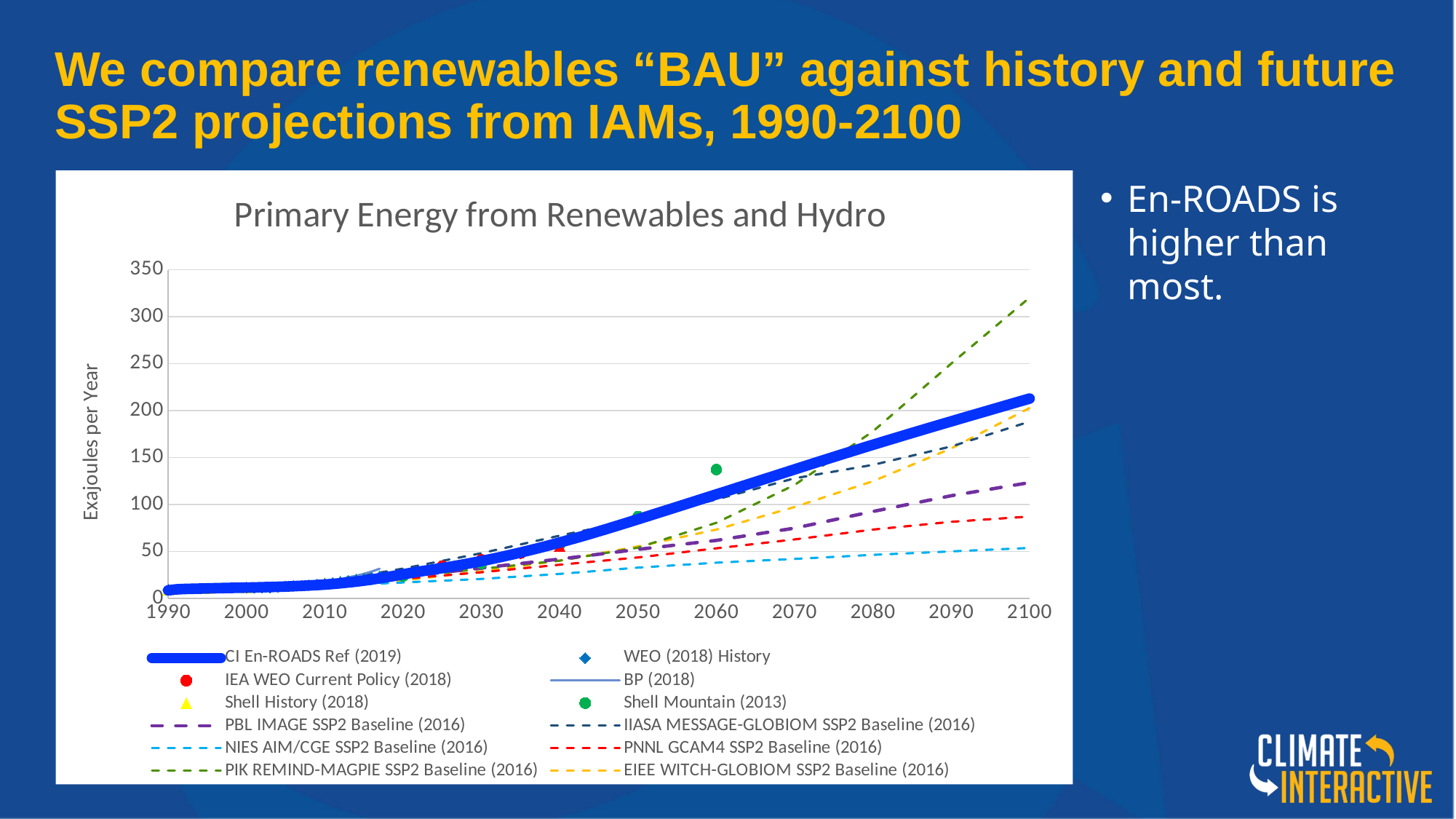
Does the CI En-ROADS Ref (2019) line rise or fall from 1990 to 2100? Rise Which series has the highest value in 2100? PIK REMIND-MAGPIE SSP2 Baseline (2016) Is the Shell Mountain (2013) point in 2060 greater or less than 100? greater Is the value for PNNL GCAM4 SSP2 Baseline (2016) in 2100 greater or less than 100? less What kind of chart is shown on the slide? Line chart How many series does the chart's legend list? 12 Which series has the lowest value in 2100? NIES AIM/CGE SSP2 Baseline (2016) Is the value for CI En-ROADS Ref (2019) in 2100 greater or less than 200? greater What is the title of the chart? Primary Energy from Renewables and Hydro What is the label on the vertical axis of the chart? Exajoules per Year In 2100, which is larger: CI En-ROADS Ref (2019) or PBL IMAGE SSP2 Baseline (2016)? CI En-ROADS Ref (2019)